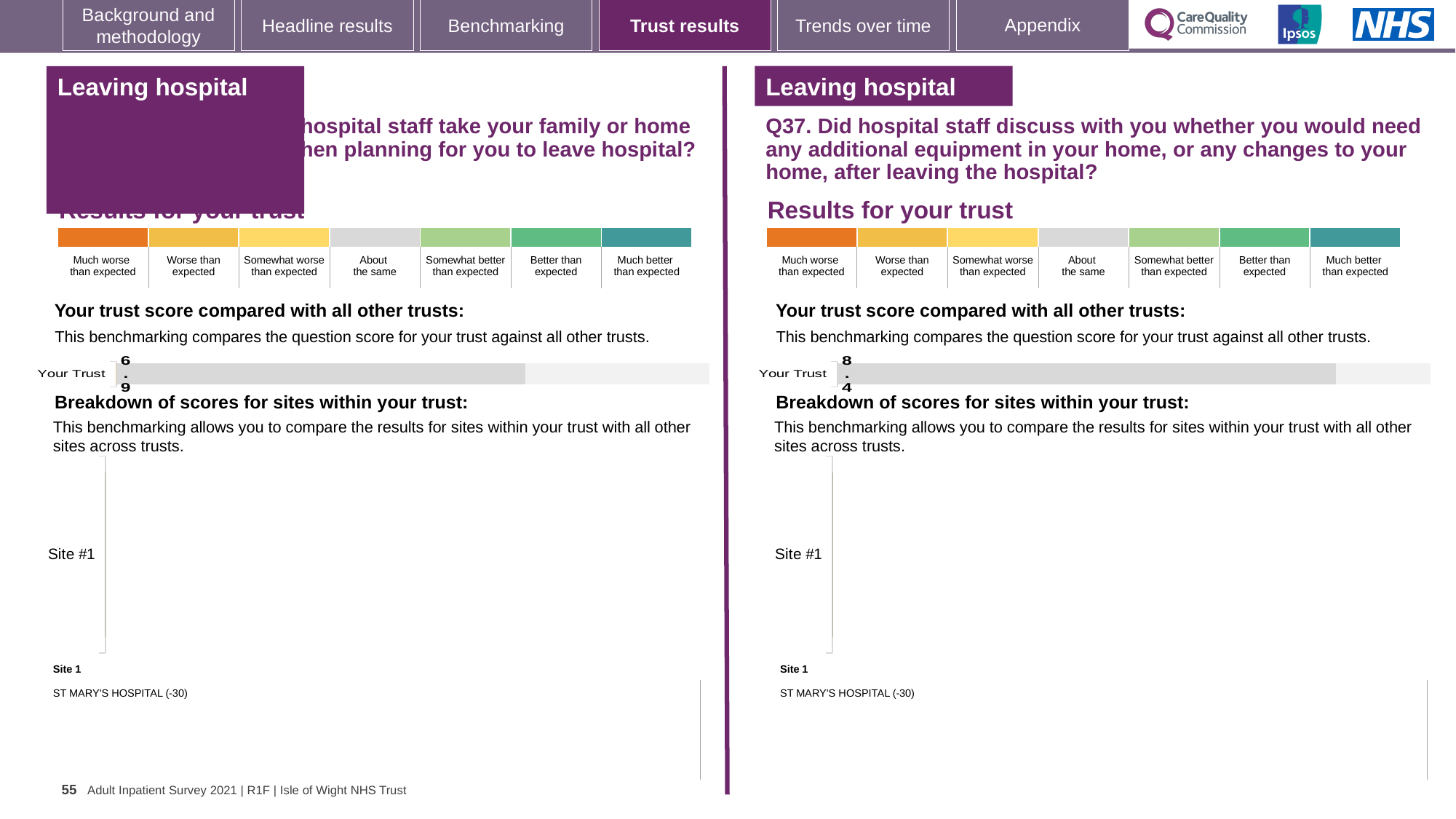
On the left chart under 'Your trust score compared with all other trusts', what is the score for Your Trust? 6.9 Which site is listed as Site 1 beneath the site breakdown chart on the right side (Q37)? ST MARY'S HOSPITAL (-30) What is the label of the single category in the 'Your trust score compared with all other trusts' chart on the left side? Your Trust How many categories are plotted in the 'Your trust score compared with all other trusts' chart on the right side (Q37)? 1 How many site categories are listed in the 'Breakdown of scores for sites within your trust' chart on the left side? 1 In the 'Breakdown of scores for sites within your trust' chart on the right side (Q37), what is the category label shown on the axis? Site #1 Which is larger: the Your Trust score on the left chart or the Your Trust score on the right chart (Q37)? The right chart (Q37), 8.4 On the right chart (Q37) under 'Your trust score compared with all other trusts', what is the score for Your Trust? 8.4 What is the difference between the Your Trust score on the right chart (Q37) and the Your Trust score on the left chart? 1.5 What kind of chart is used to show the Your Trust score on the left side of the slide? Bar chart